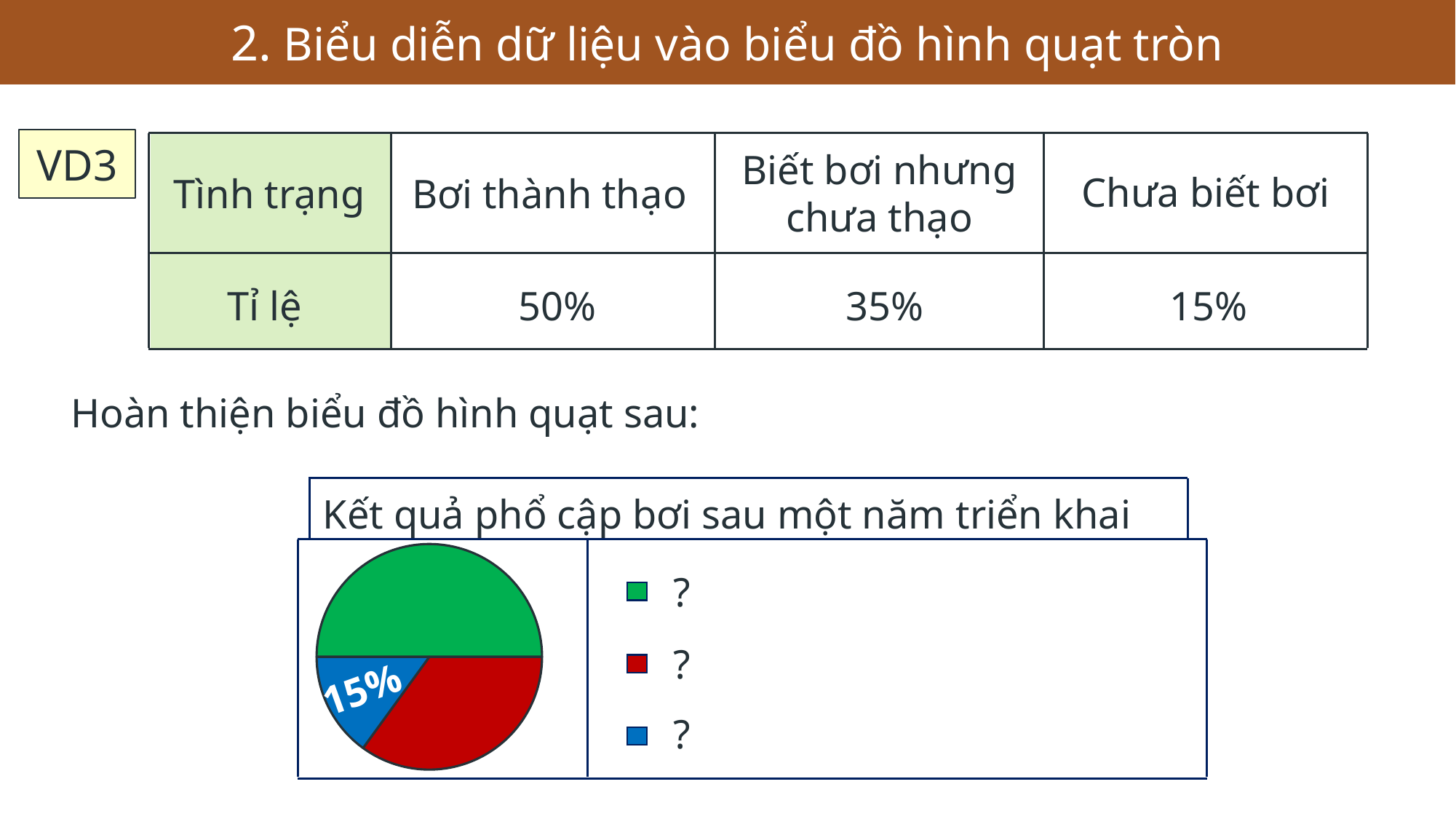
What share of the pie does the blue slice represent? 15% Which slice is larger in the pie chart, the red one or the blue one? red Which colour slice is the largest in the pie chart? green Which slice is larger in the pie chart, the green one or the red one? green What text is shown for each legend entry of the pie chart? ? What is the title of the pie chart? Kết quả phổ cập bơi sau một năm triển khai Which colour slice is the smallest in the pie chart? blue How many entries does the legend of the pie chart list? 3 What kind of chart is shown on the slide? pie chart What percentage is printed on the blue slice of the pie chart? 15% How many slices does the pie chart have? 3